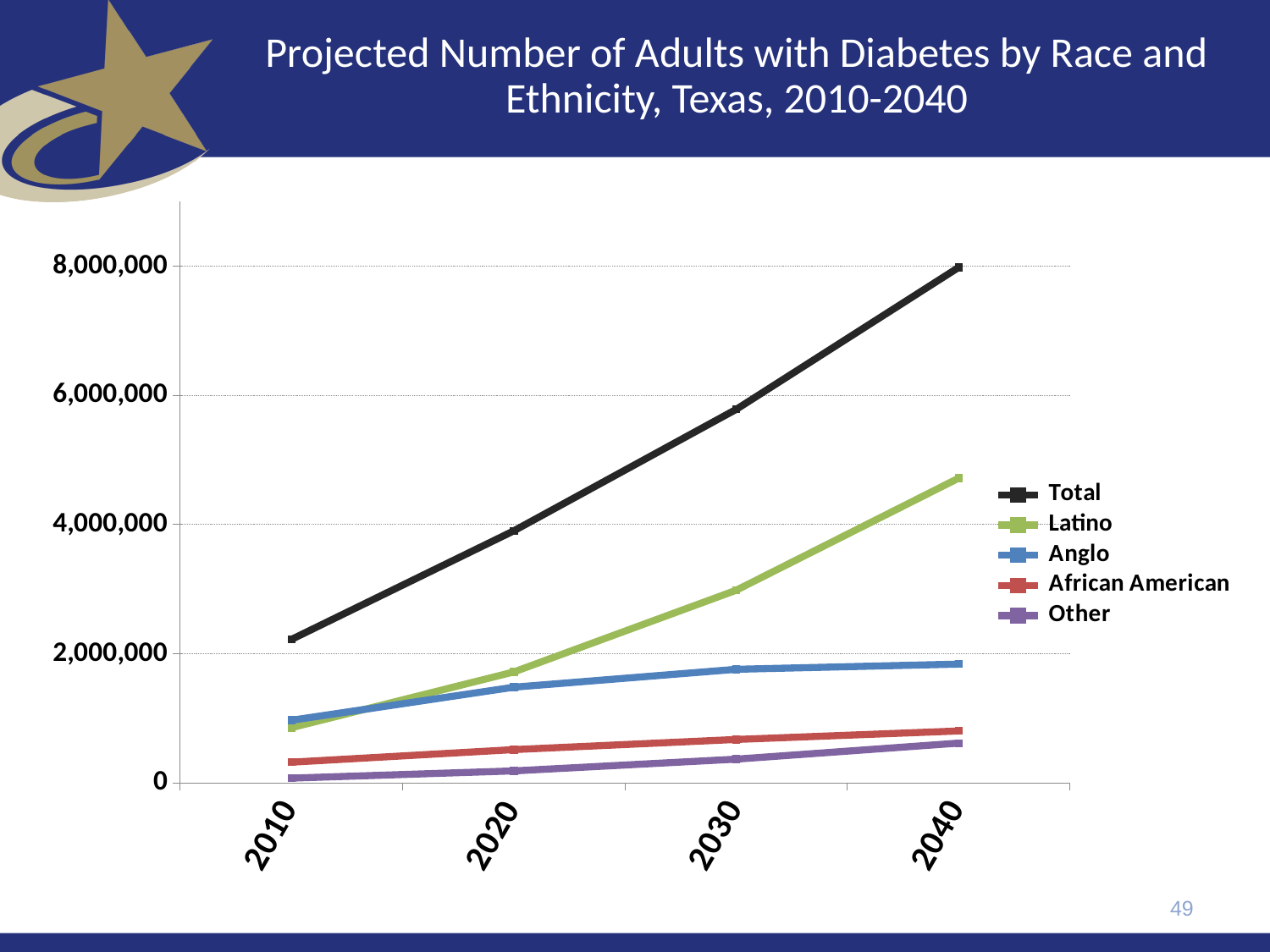
How many series does the legend list? 5 Is the Total value for 2030 greater or less than 4,000,000? greater What kind of chart is shown on the slide? line chart How many years are plotted along the x axis? 4 Is the Anglo value for 2040 greater or less than 2,000,000? less Is the Latino value for 2040 greater or less than 4,000,000? greater What colour is the line for the Total series? black In 2040, which is larger, the Latino value or the Anglo value? Latino Which race/ethnicity group (excluding Total) has the highest projected number of adults with diabetes in 2040? Latino Does the Total series rise or fall from 2010 to 2040? rise Which series has the lowest value in 2040? Other